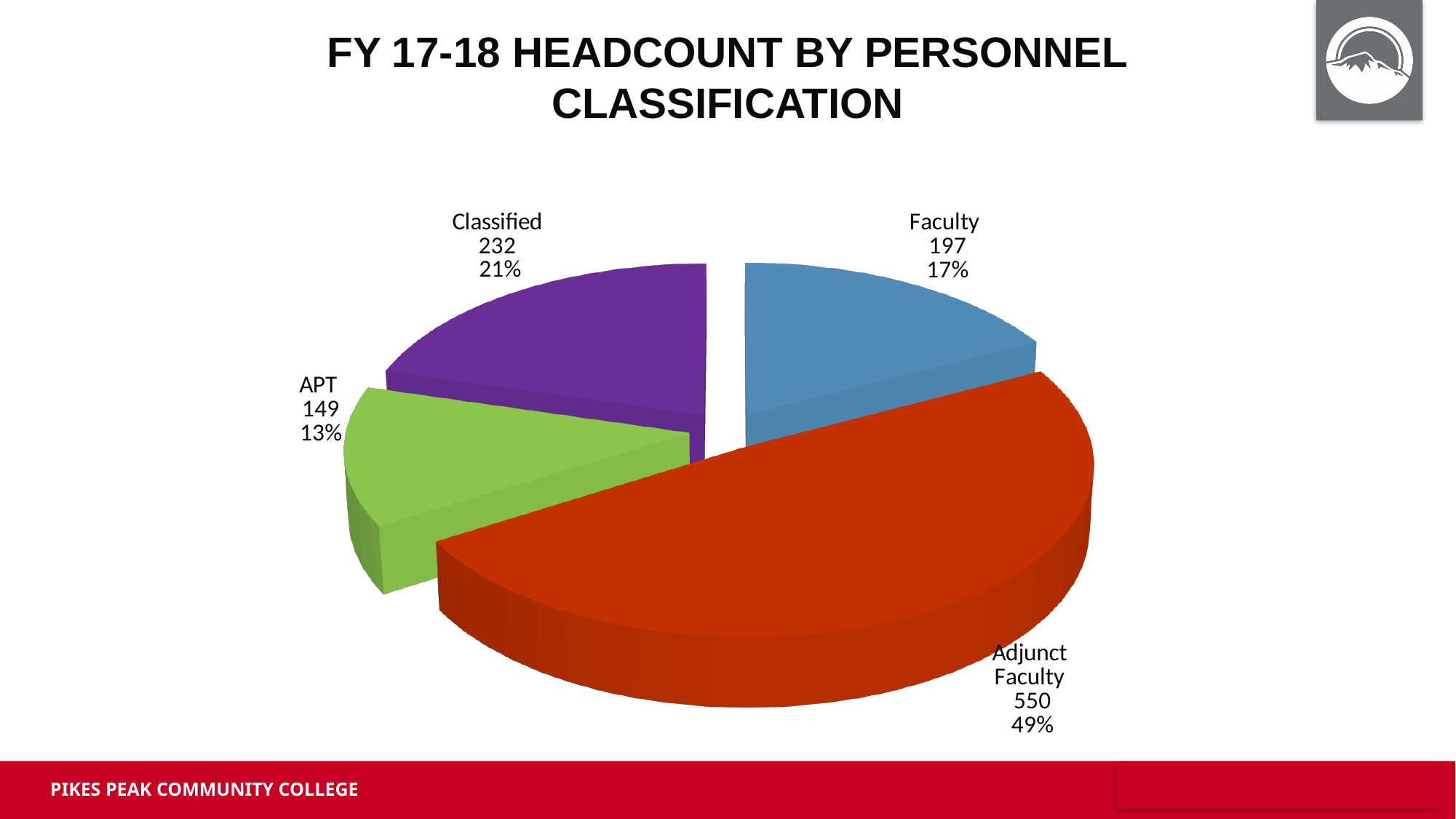
Which personnel classification has the largest headcount? Adjunct Faculty What is the headcount for Adjunct Faculty? 550 What is the difference in headcount between Classified and Faculty? 35 What percentage share does Faculty have? 17% What is the difference in headcount between Adjunct Faculty and APT? 401 What percentage share does Adjunct Faculty have? 49% How many personnel classifications are shown in the pie chart? 4 What is the headcount for Classified personnel? 232 Which personnel classification has the smallest headcount? APT What is the headcount for APT? 149 Which has a larger headcount, Classified or Faculty? Classified What type of chart is shown on the slide? Pie chart